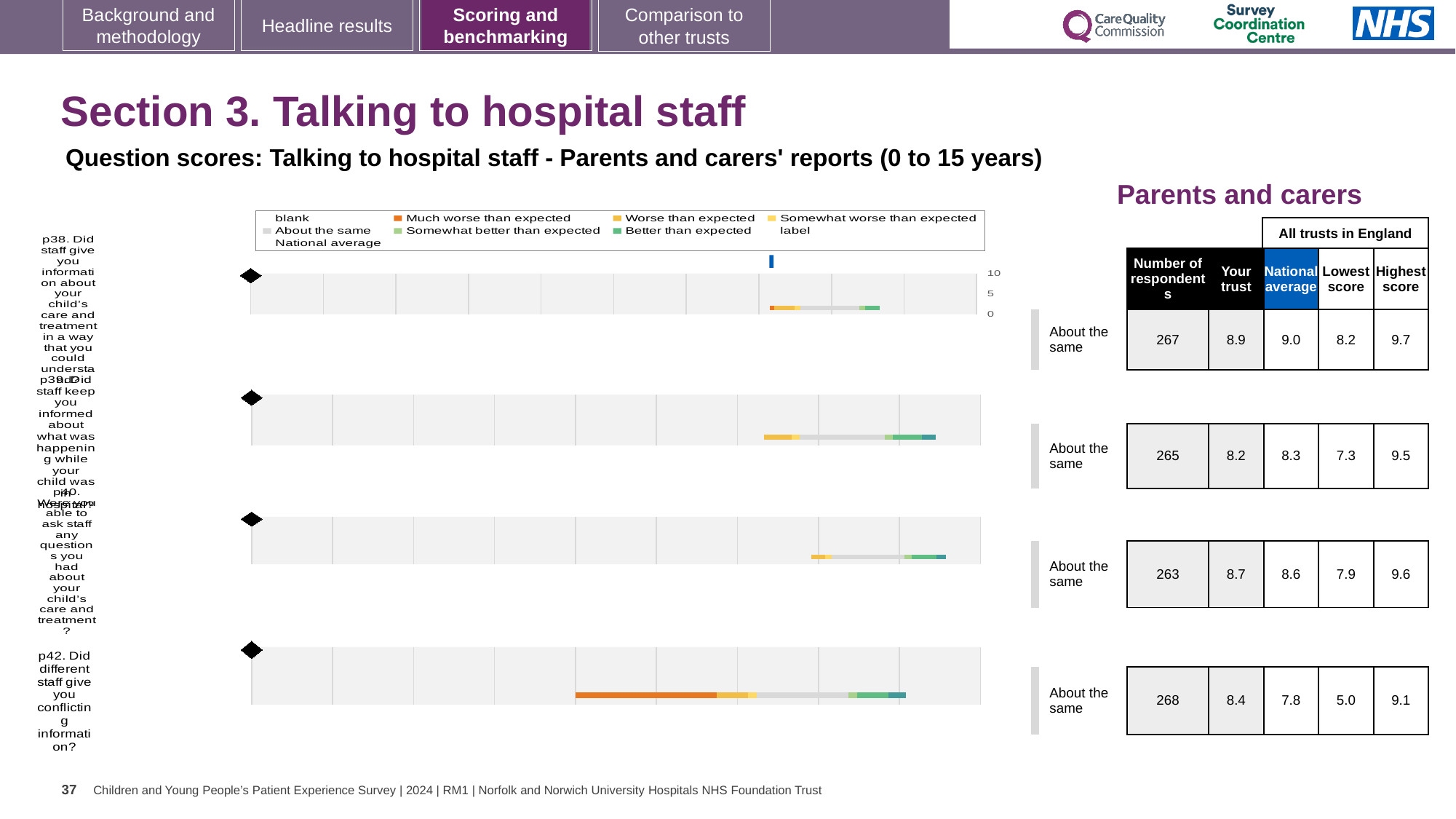
What benchmark category is shown next to each of the four bars in the chart? About the same Which question has the lowest 'Your trust' score in the table beside the chart? p39 For p40, is the 'Your trust' score or the National average larger in the table beside the chart? Your trust In the table beside the chart, what is the National average for p42 (Did different staff give you conflicting information)? 7.8 What kind of chart is used to show the question scores on this slide? bar chart What colour does the chart legend use for 'Much worse than expected'? orange How many survey questions (bars) are plotted in the chart? 4 In the table beside the chart, how many respondents answered p39 (Did staff keep you informed about what was happening while your child was in hospital)? 265 In the table beside the chart, what is the Lowest score for p42? 5.0 Which question has the highest 'Your trust' score in the table beside the chart? p38 What is the difference between the Highest score and the Lowest score for p42 in the table beside the chart? 4.1 In the table beside the chart, what is the 'Your trust' score for p38 (Did staff give you information about your child's care and treatment in a way that you could understand)? 8.9